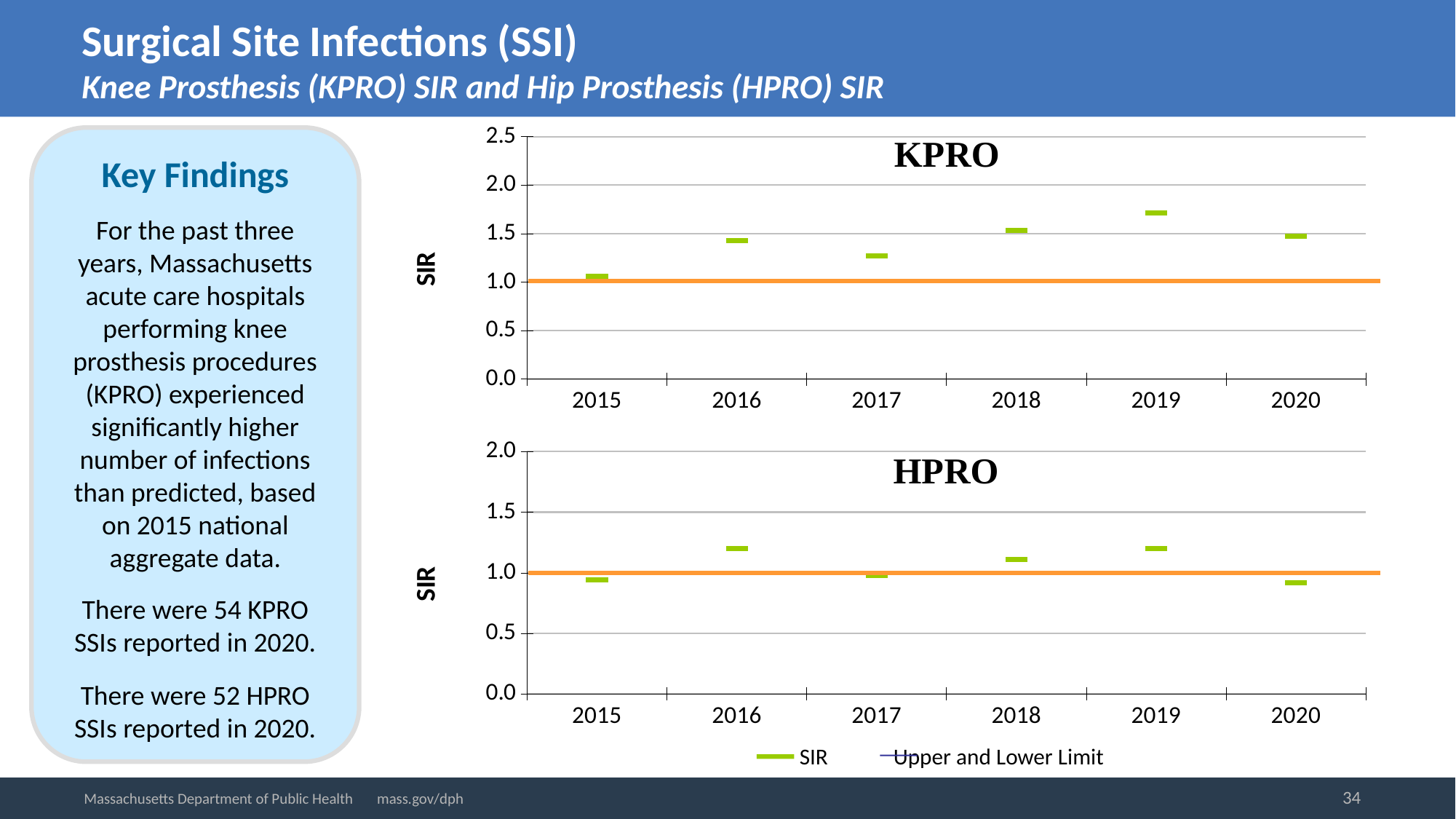
How many series does the legend below the HPRO chart list? 2 In the KPRO chart, is the SIR for 2019 greater or less than 1.5? greater In the KPRO chart, which year has the lowest SIR? 2015 What does the orange horizontal line in the charts represent, according to the legend? Upper and Lower Limit In the KPRO chart, is the SIR for 2017 greater or less than 1.5? less How many years are shown on the x axis of the KPRO chart? 6 In the KPRO chart, which year has the highest SIR? 2019 In the KPRO chart, which is larger, the SIR for 2016 or the SIR for 2017? 2016 In the HPRO chart, which is larger, the SIR for 2018 or the SIR for 2020? 2018 What is the label on the y axis of the HPRO chart? SIR In the HPRO chart, is the SIR for 2020 greater or less than 1.0? less